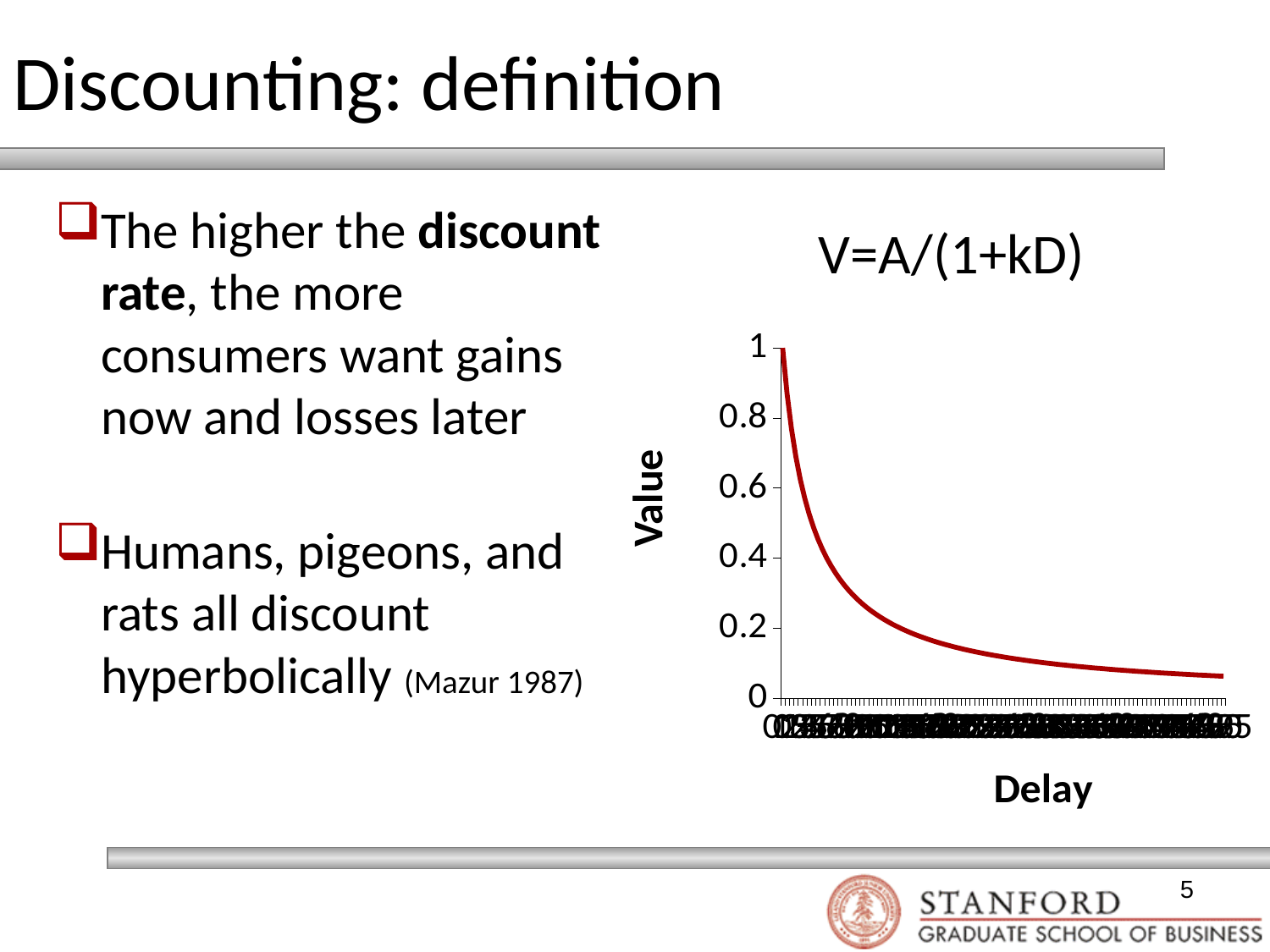
Is the value at the right end of the curve greater or less than 0.2? less What is the highest value reached by the curve on the chart? 1 Do the values on the chart rise or fall as Delay increases along the x axis? fall Is the value at the right end of the curve greater or less than 0.4? less What is the title of the chart? V=A/(1+kD) Is the value at the left end of the curve greater or less than 0.8? greater What kind of chart is shown on the slide? line chart Which end of the curve has the larger value, the left end or the right end? left end What is the label of the y axis of the chart? Value